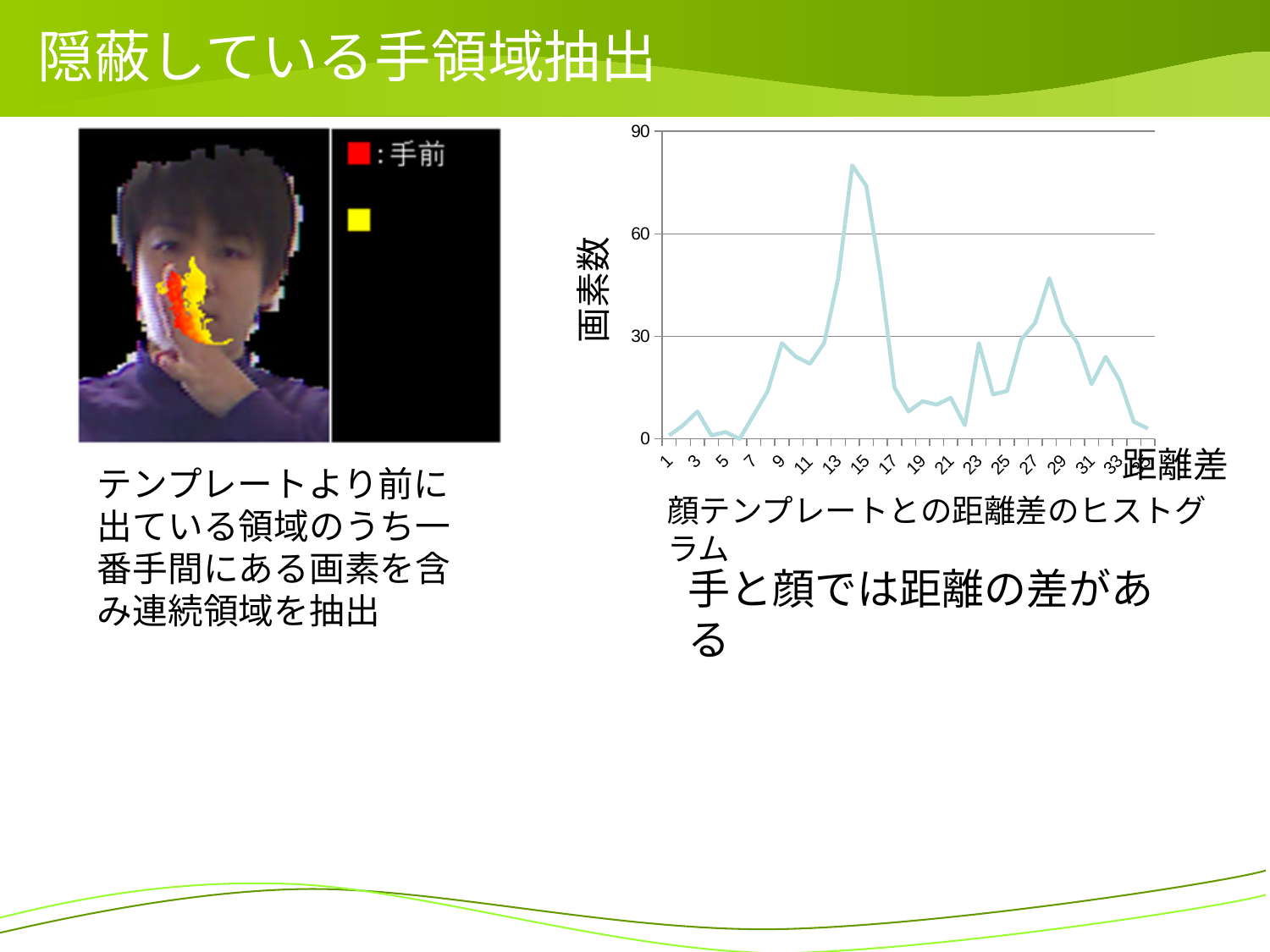
What is the label of the horizontal axis of the chart? 距離差 Is the value at distance difference 33 greater or less than 30? less Is the highest value plotted on the chart greater or less than 60? greater Which is larger, the value at distance difference 15 or the value at distance difference 29? 15 Is the value at distance difference 19 greater or less than 30? less What is the highest tick value shown on the vertical axis? 90 What kind of chart is shown on the right of the slide? line chart Between distance difference 15 and 19, do the values rise or fall? fall What is the label of the vertical axis of the chart? 画素数